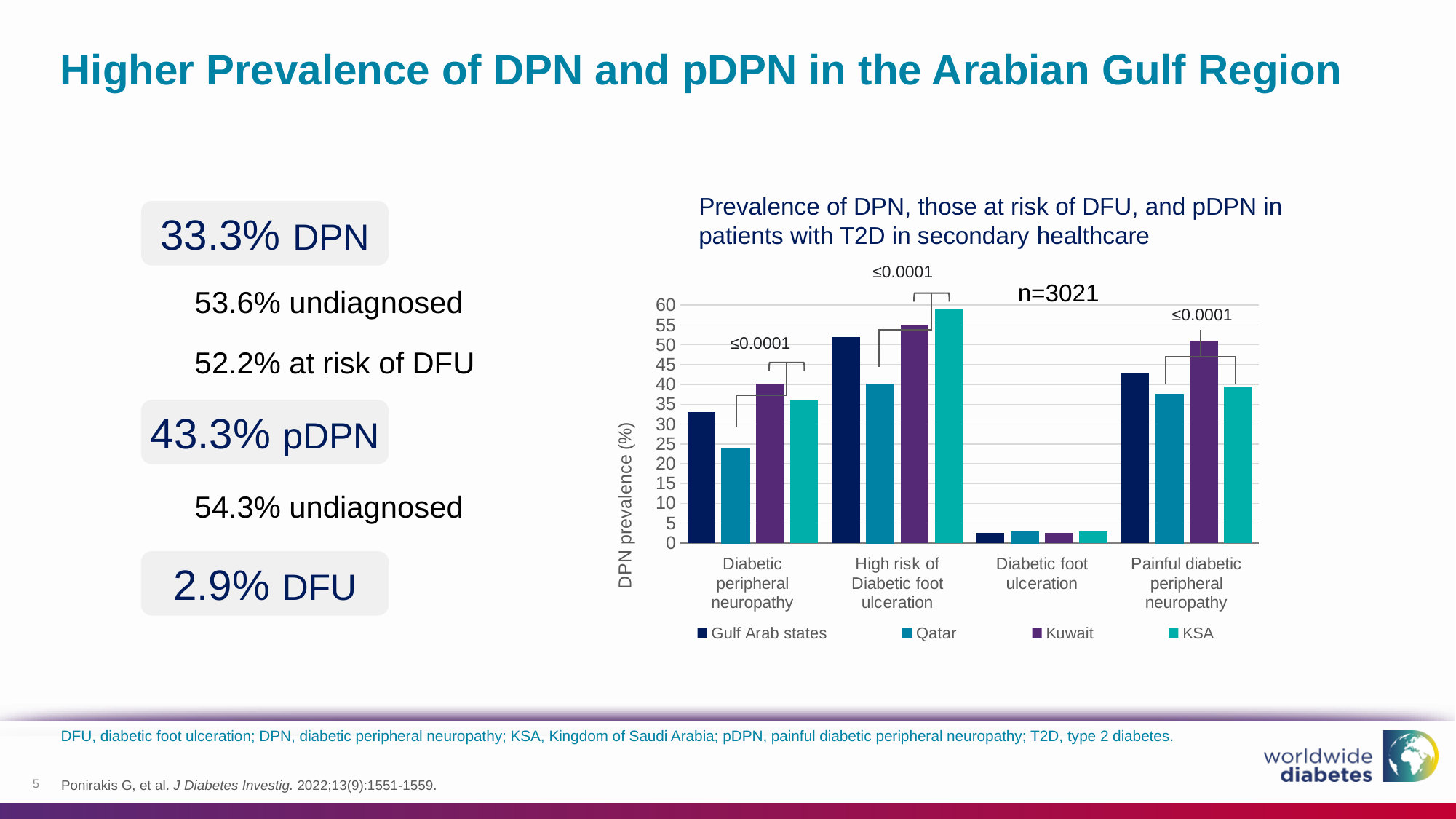
In the Painful diabetic peripheral neuropathy category, is the bar for Kuwait or Qatar larger? Kuwait How many series does the chart legend list? 4 What kind of chart is shown on the slide? bar chart What is the label of the y axis of the chart? DPN prevalence (%) What sample size (n) is shown on the chart? n=3021 Which category has the lowest values across all series? Diabetic foot ulceration In the Diabetic peripheral neuropathy category, which series has the highest bar? Kuwait Is the value for KSA in the High risk of Diabetic foot ulceration category greater or less than 55? greater How many categories are shown along the x axis of the chart? 4 In the High risk of Diabetic foot ulceration category, which series has the highest bar? KSA In the Diabetic peripheral neuropathy category, which series has the lowest bar? Qatar Is the value for Qatar in the Diabetic peripheral neuropathy category greater or less than 30? less